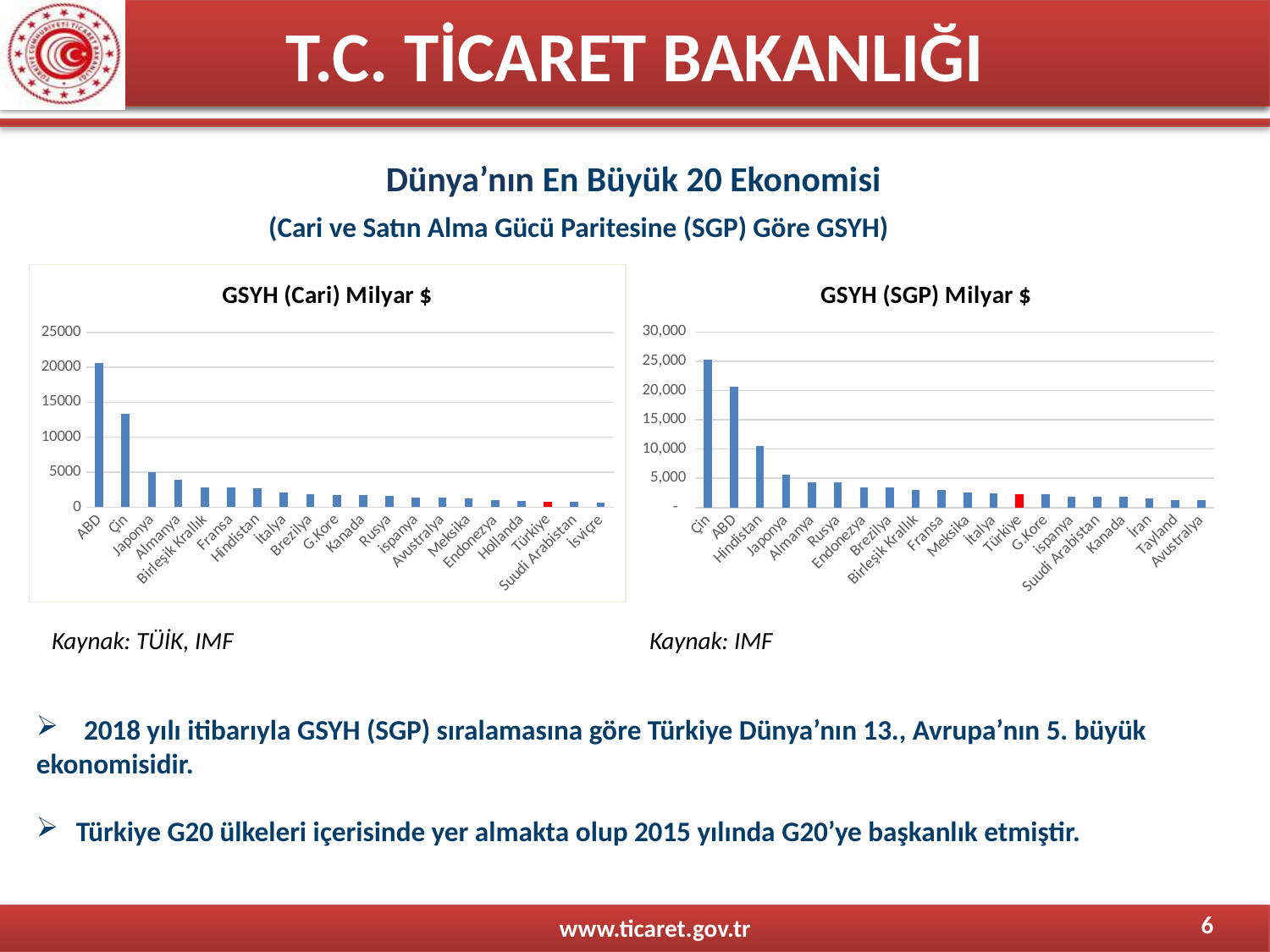
In the 'GSYH (SGP) Milyar $' chart on the right, which country's bar is coloured red? Türkiye In the 'GSYH (SGP) Milyar $' chart on the right, do the values rise or fall from left to right along the x axis? fall How many countries are shown in the 'GSYH (Cari) Milyar $' chart on the left? 20 In the 'GSYH (SGP) Milyar $' chart on the right, which is larger, the value for Çin or the value for ABD? Çin In the 'GSYH (Cari) Milyar $' chart on the left, which country has the highest value? ABD What kind of chart is the 'GSYH (Cari) Milyar $' chart on the left? bar chart In the 'GSYH (Cari) Milyar $' chart on the left, is the value for Almanya greater or less than 5000? less In the 'GSYH (SGP) Milyar $' chart on the right, is the value for Türkiye greater or less than 5,000? less In the 'GSYH (Cari) Milyar $' chart on the left, is the value for ABD greater or less than 20000? greater In the 'GSYH (SGP) Milyar $' chart on the right, which country has the highest value? Çin